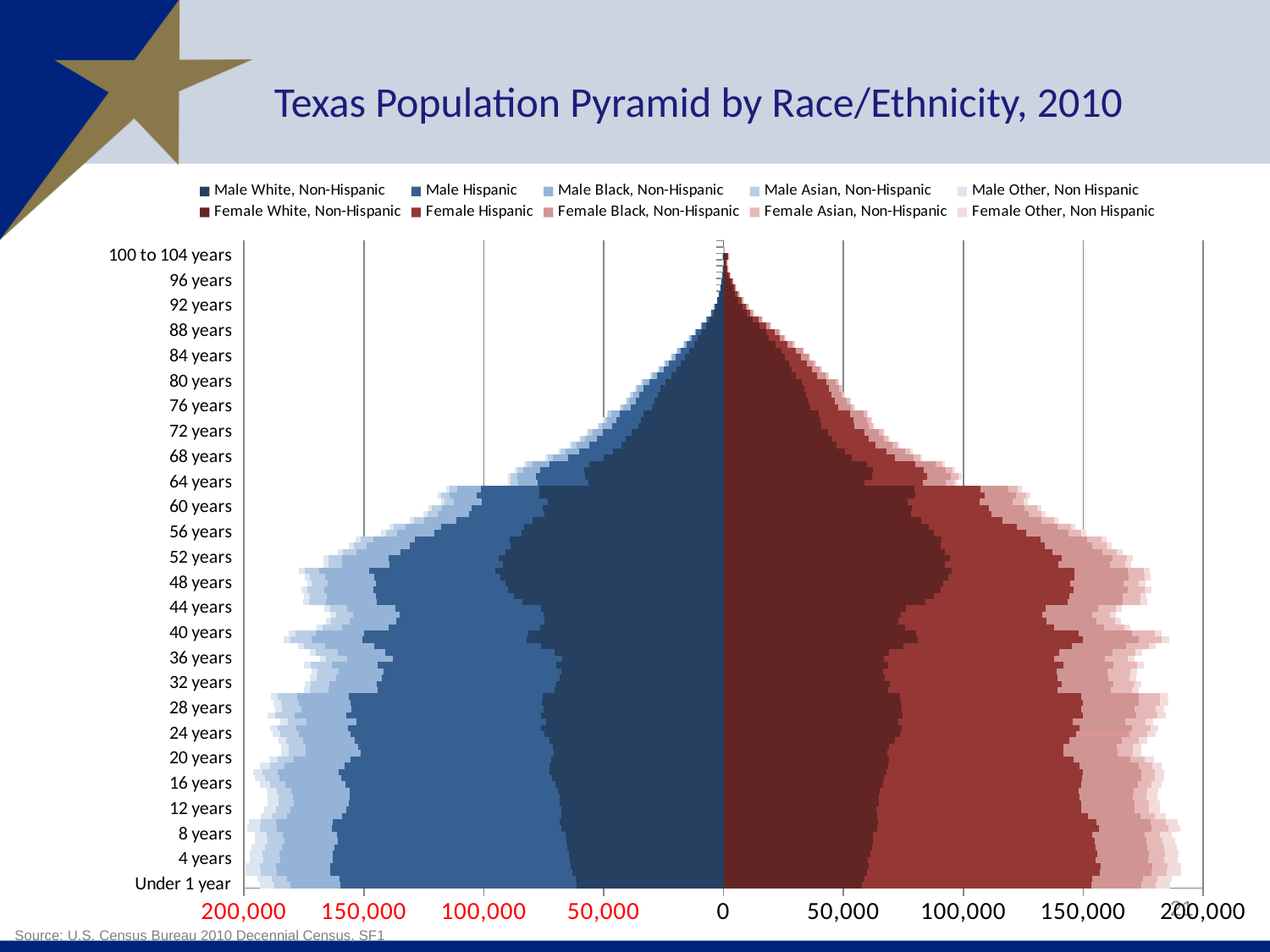
Moving from the youngest age groups to the oldest, do the bar lengths generally rise or fall? Fall What kind of chart is shown on the slide? Bar chart (population pyramid) What is the title of the chart? Texas Population Pyramid by Race/Ethnicity, 2010 At Under 1 year, which is larger: the Male Hispanic segment or the Male White, Non-Hispanic segment? Male Hispanic Is the total male population at 100 to 104 years greater or less than 50,000? less Which colour family is used for the male series and which for the female series? Blue for male, red for female Is the total male population for the Under 1 year age group greater or less than 150,000? greater Is the total male population at 80 years greater or less than 50,000? less How many series does the legend list? 10